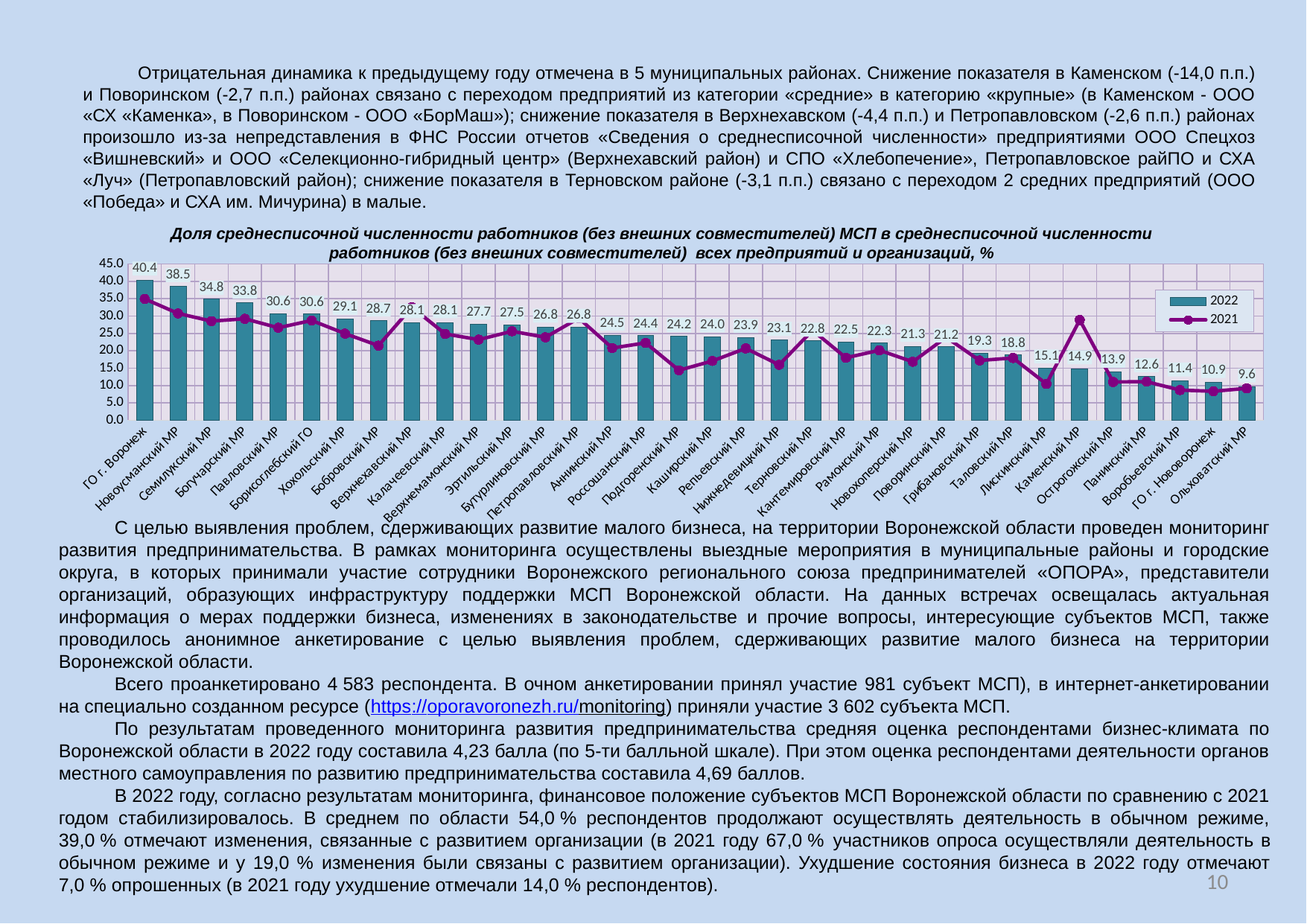
Which category has the highest 2022 value? ГО г. Воронеж How many series does the legend list? 2 Which category has the lowest 2022 value? Ольховатский МР What kind of chart is used for the 2022 series? bar chart Which has the larger 2022 value, Семилукский МР or Грибановский МР? Семилукский МР Do the 2022 values rise or fall from left to right along the x axis? fall Is the 2021 value for Каменский МР greater or less than 25.0? greater What is the 2022 value for Новоусманский МР? 38.5 What is the difference between the 2022 values for ГО г. Воронеж and Ольховатский МР? 30.8 What is the 2022 value for Лискинский МР? 15.1 How many categories are shown on the x axis? 34 What is the 2022 value for Терновский МР? 22.8